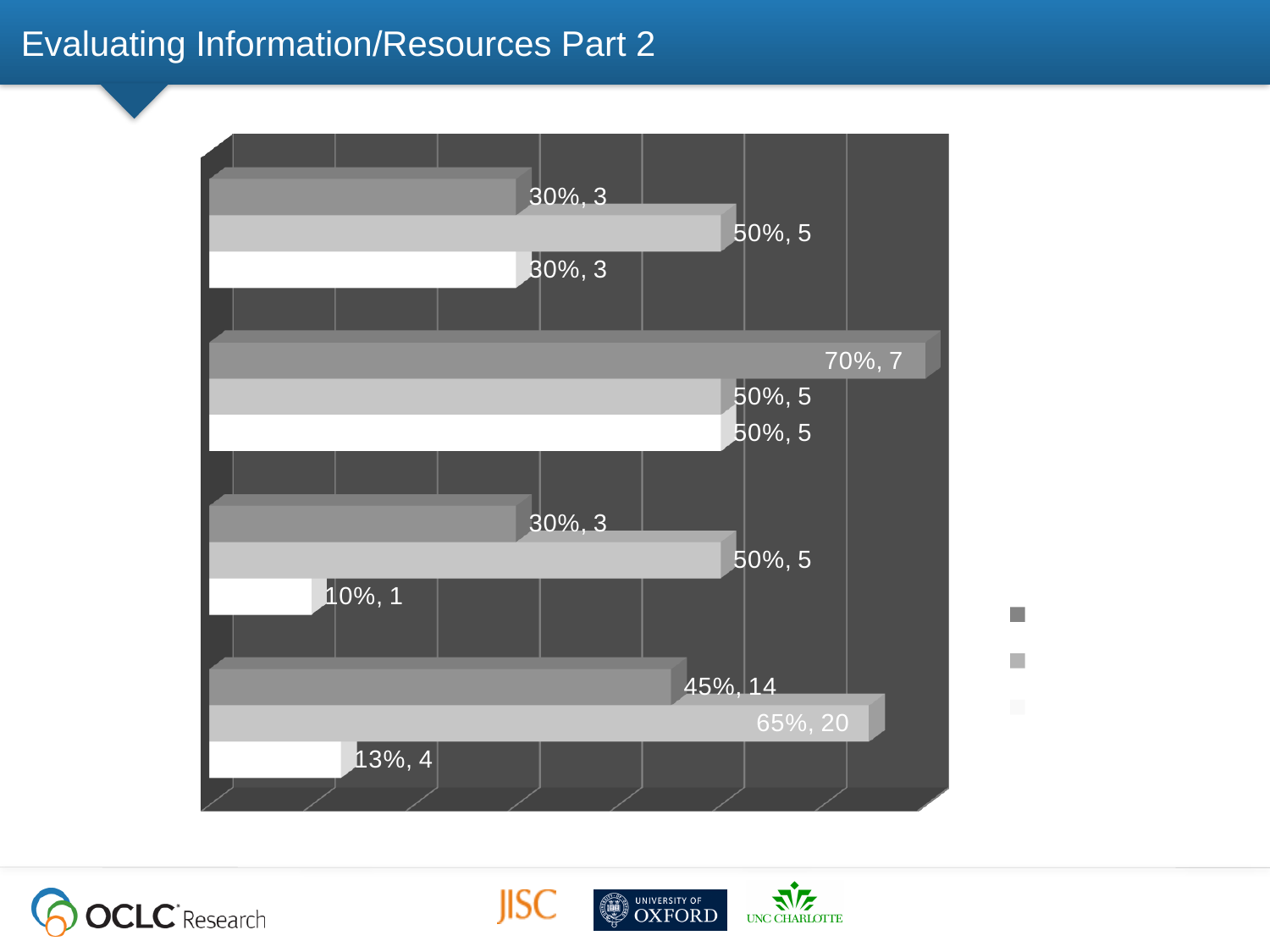
What kind of chart is shown on the slide? bar chart In the top group, what is the difference in percentage points between the light grey bar (50%) and the dark grey bar (30%)? 20 What is the title of the slide containing the chart? Evaluating Information/Resources Part 2 What is the data label on the light grey bar in the bottom group? 65%, 20 What is the data label on the white bar in the bottom group? 13%, 4 What is the highest percentage printed on any bar in the chart? 70% In the bottom group, what is the difference between the count on the light grey bar (20) and the count on the dark grey bar (14)? 6 How many series does the legend list? 3 What is the lowest percentage printed on any bar in the chart? 10% What is the data label on the dark grey bar in the second group from the top? 70%, 7 How many groups of bars does the chart contain? 4 In the third group from the top, which is larger: the light grey bar or the white bar? the light grey bar